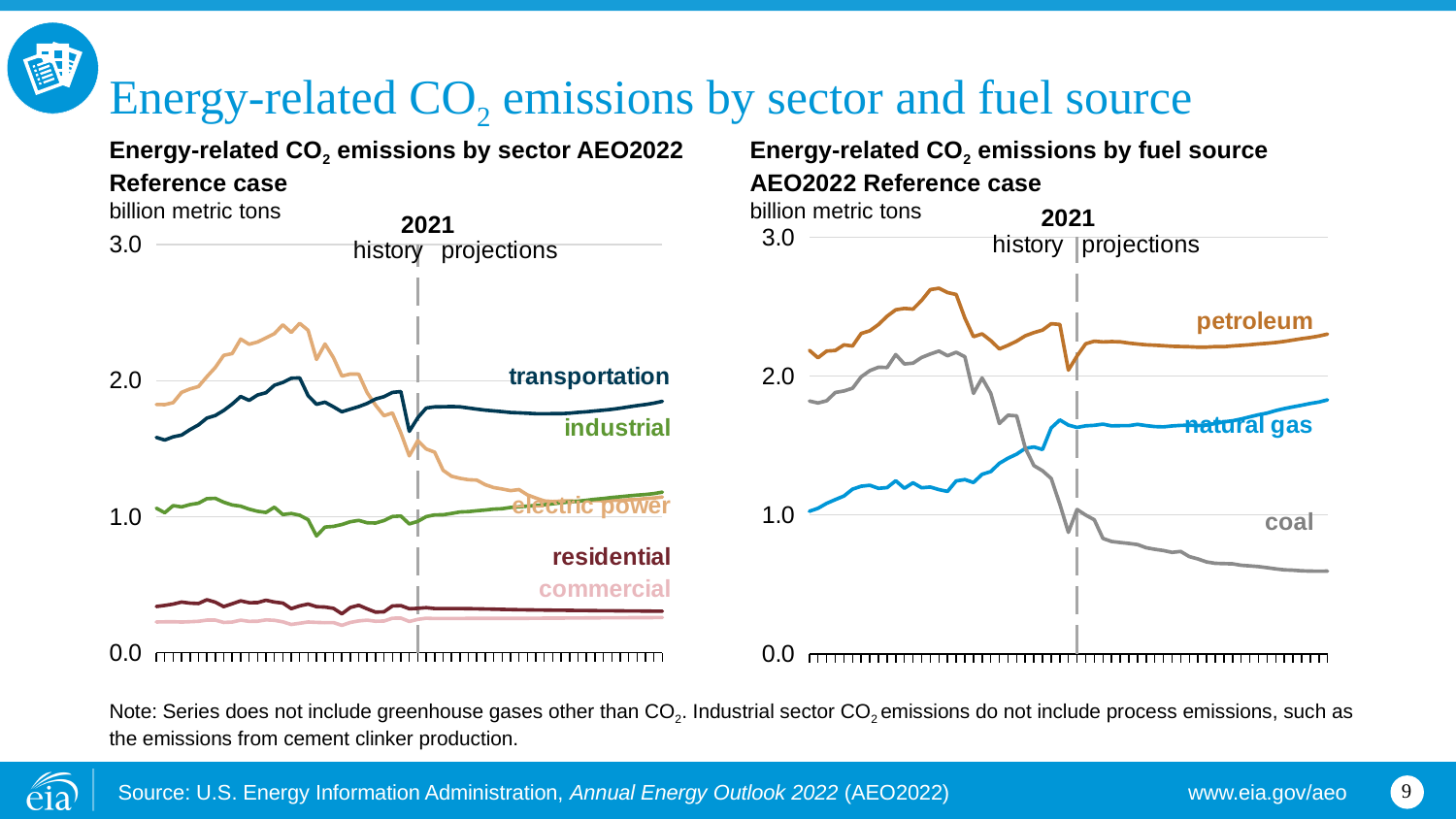
How many labelled series are shown in the 'Energy-related CO2 emissions by sector' chart on the left? 5 How many labelled series are shown in the 'Energy-related CO2 emissions by fuel source' chart on the right? 3 In the 'Energy-related CO2 emissions by sector' chart on the left, is the peak value for electric power greater or less than 2.0? greater In the 'Energy-related CO2 emissions by sector' chart on the left, which is larger at the end of the projection period, transportation or industrial? transportation In the 'Energy-related CO2 emissions by sector' chart on the left, which sector has the highest emissions at the end of the projection period? transportation In the 'Energy-related CO2 emissions by fuel source' chart on the right, is the value for coal at the end of the projection period greater or less than 1.0? less In the 'Energy-related CO2 emissions by fuel source' chart on the right, which fuel source has the lowest emissions at the end of the projection period? coal In the 'Energy-related CO2 emissions by fuel source' chart on the right, does the coal series rise or fall over the history period? fall What unit is used on the y axis of both charts? billion metric tons In the 'Energy-related CO2 emissions by sector' chart on the left, which sector has the lowest emissions throughout the chart? commercial In the 'Energy-related CO2 emissions by fuel source' chart on the right, which fuel source has the highest emissions at the end of the projection period? petroleum What kind of chart is the 'Energy-related CO2 emissions by sector' chart on the left? line chart